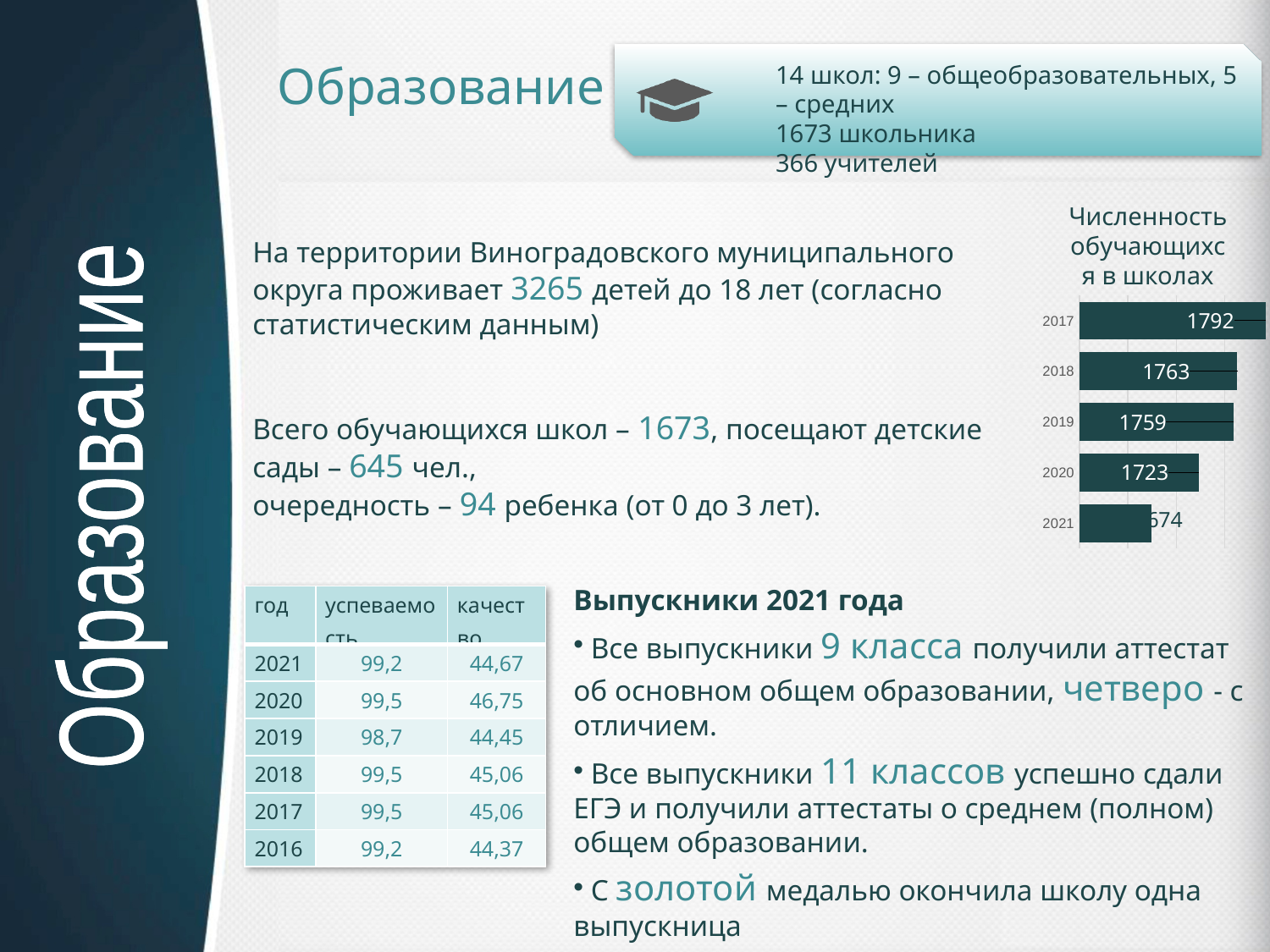
Which year has the lowest number of students in the chart? 2021 What type of chart is shown on the slide? bar chart What is the value for 2020 in the chart? 1723 What is the value for 2018 in the chart? 1763 Do the values in the chart rise or fall from 2017 to 2021? fall Which is larger, the value for 2019 or the value for 2020? 2019 How many years (categories) are shown in the chart? 5 Which year has the highest number of students in the chart? 2017 What is the value for 2017 in the chart? 1792 What is the difference between the values for 2017 and 2018? 29 What is the title of the chart on the slide? Численность обучающихся в школах What is the value for 2019 in the chart? 1759